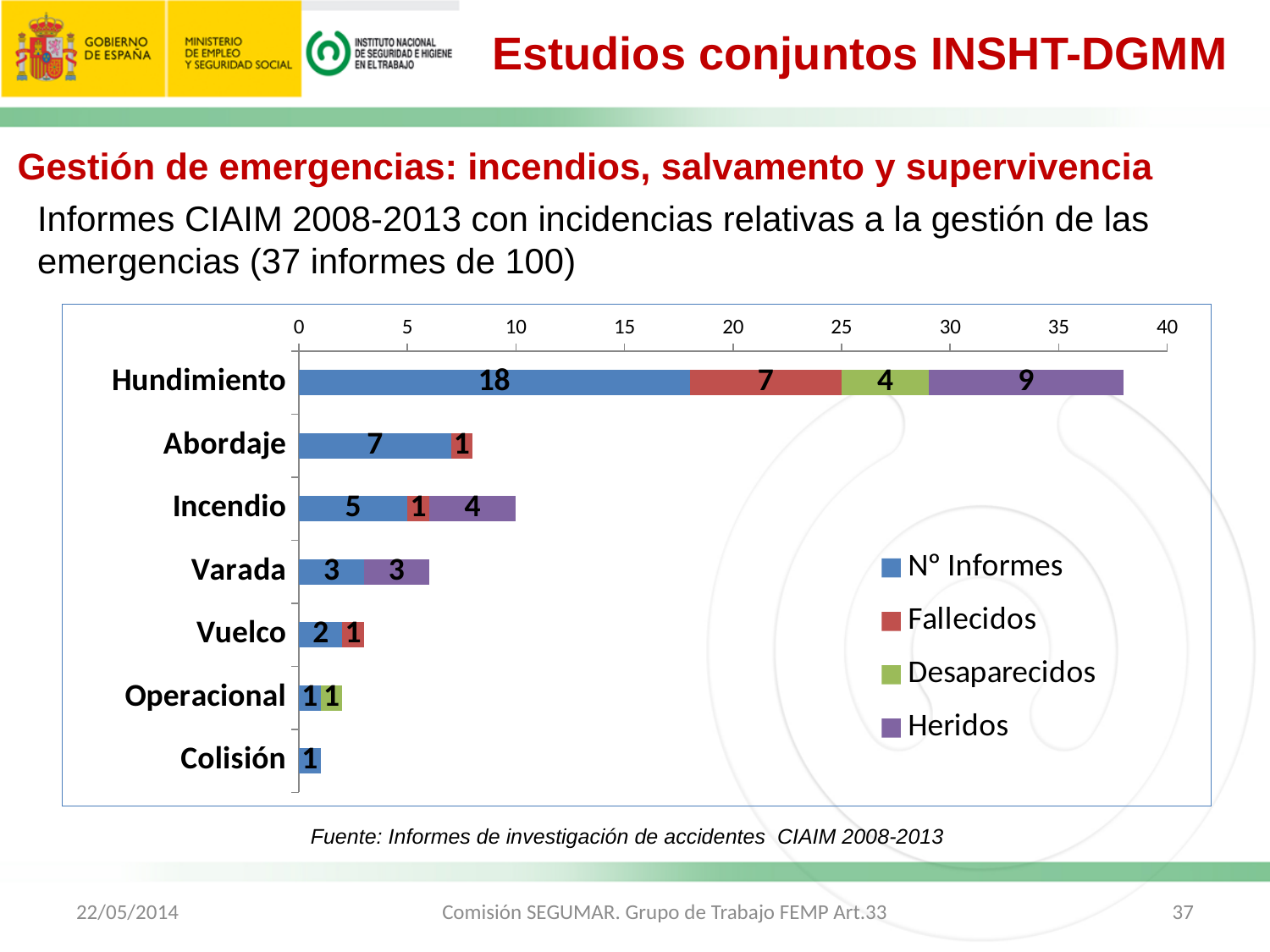
What is the total of the stacked bar for Hundimiento? 38 What is the Nº Informes value for Hundimiento? 18 What is the Fallecidos value for Abordaje? 1 Which is larger, the Heridos value for Hundimiento or the Heridos value for Varada? Hundimiento What is the difference between the Nº Informes values for Hundimiento and Abordaje? 11 What type of chart is shown on the slide? Stacked bar chart What is the total of the stacked bar for Incendio? 10 Which category has the lowest total stacked bar? Colisión Which category has the highest Nº Informes value? Hundimiento How many categories are shown on the chart? 7 How many series does the legend list? 4 What is the Heridos value for Incendio? 4